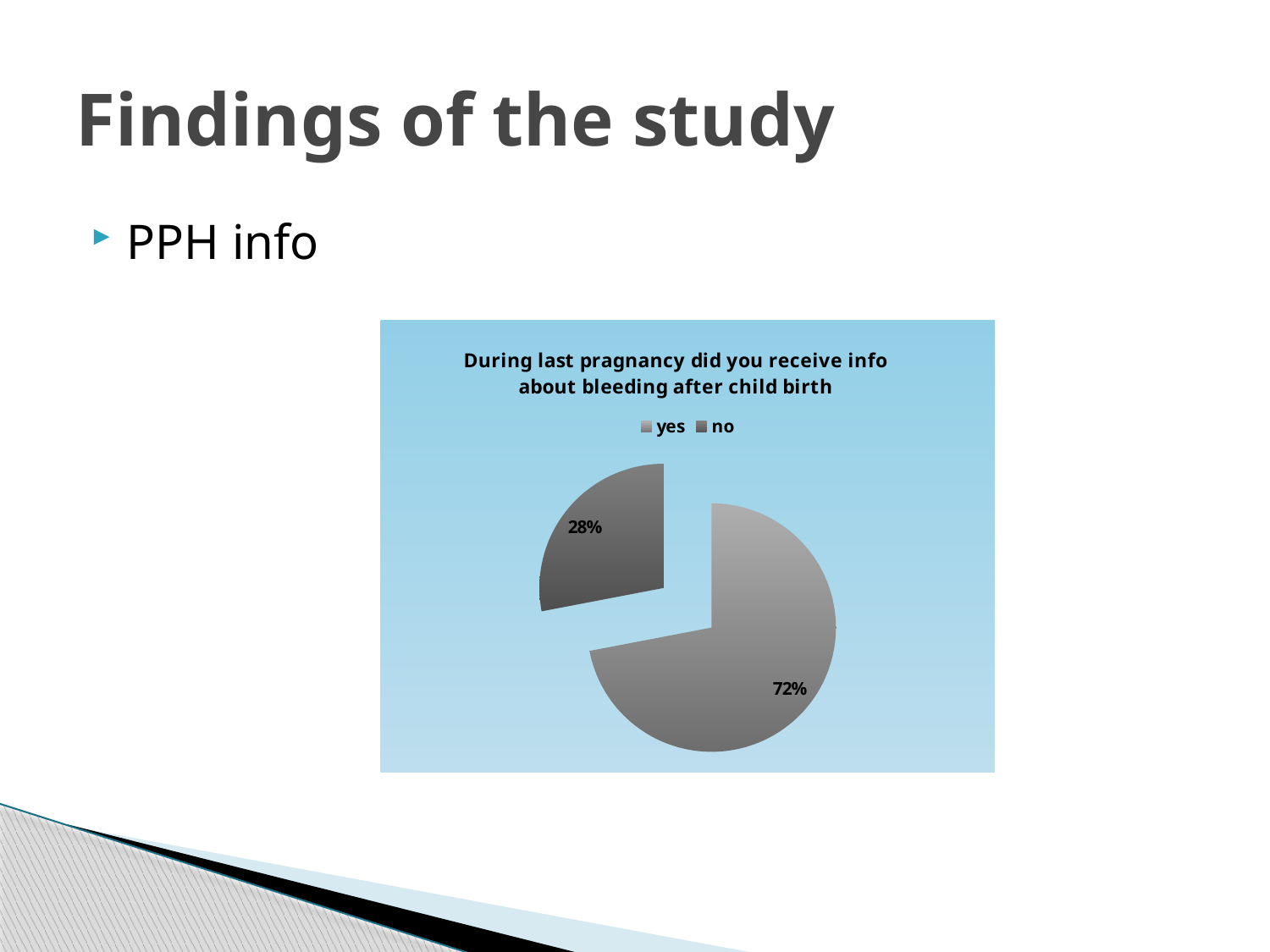
Which slice is pulled out (exploded) from the pie? no Which response has the largest share of the pie? yes How many entries does the legend list? 2 Which response has the smallest share of the pie? no What share of the pie does the "no" slice represent? 28% What percentage of respondents answered "yes"? 72% What is the difference in percentage points between the "yes" and "no" slices? 44 What type of chart is shown on the slide? pie chart Which is larger, the "yes" slice or the "no" slice? yes What is the title of the chart? During last pragnancy did you receive info about bleeding after child birth What percentage of respondents answered "no"? 28% How many slices does the pie chart have? 2